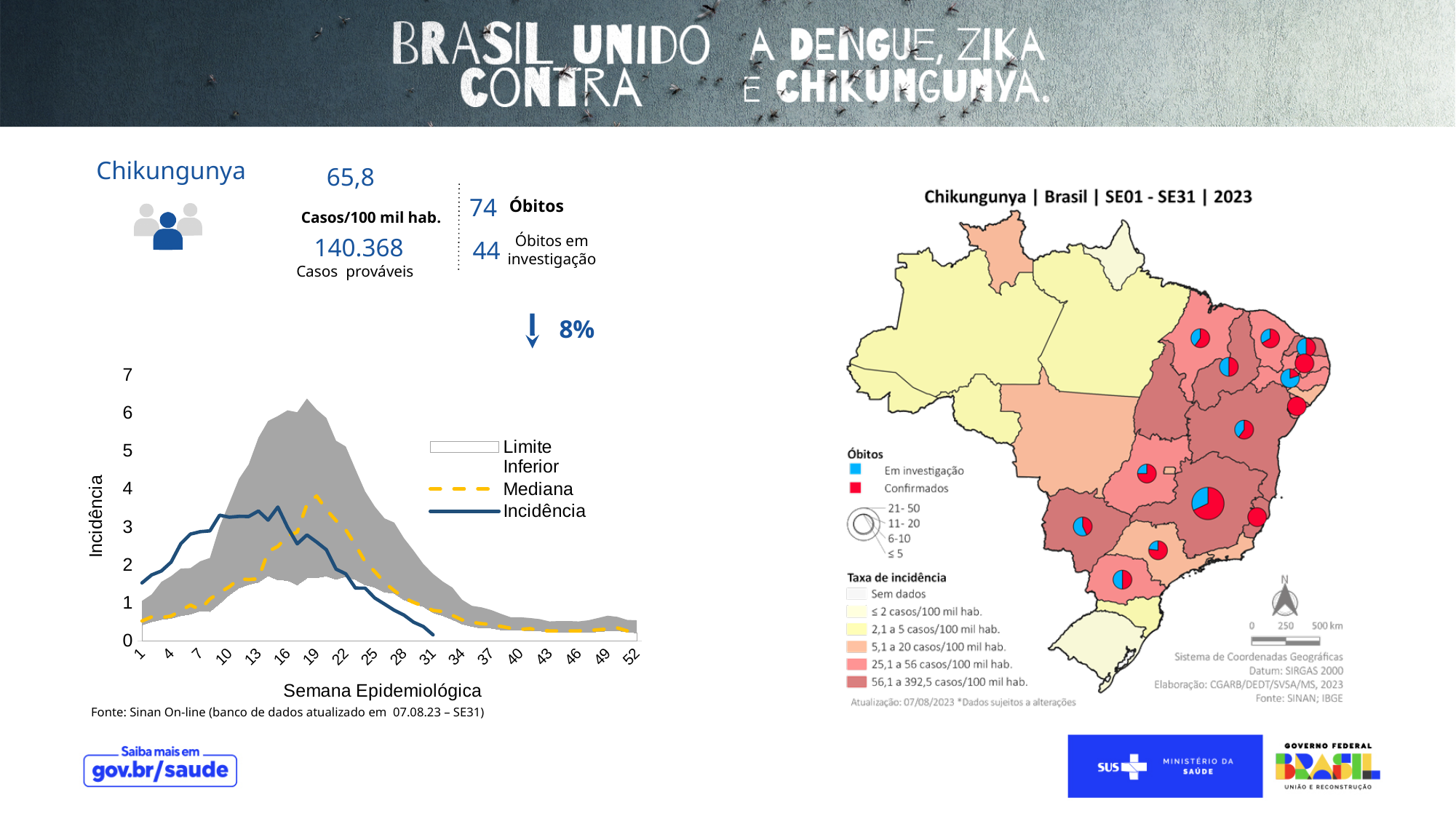
In the line chart, is the Mediana value at week 19 greater or less than 3? greater What is the label of the y axis of the line chart? Incidência In the line chart, at week 7, which is larger: the Incidência line or the Mediana line? Incidência In the line chart, at which epidemiological week does the Mediana line reach its highest value? 19 What is the label of the x axis of the line chart? Semana Epidemiológica In the line chart, is the Incidência value at week 1 greater or less than 2? less In the line chart, at week 25, which is larger: the Incidência line or the Mediana line? Mediana In the line chart, does the Incidência line rise or fall between week 16 and week 31? fall In the line chart, is the Incidência value at week 31 greater or less than 1? less What kind of chart is the chart on the left of the slide? combination area and line chart How many series does the legend of the line chart list? 3